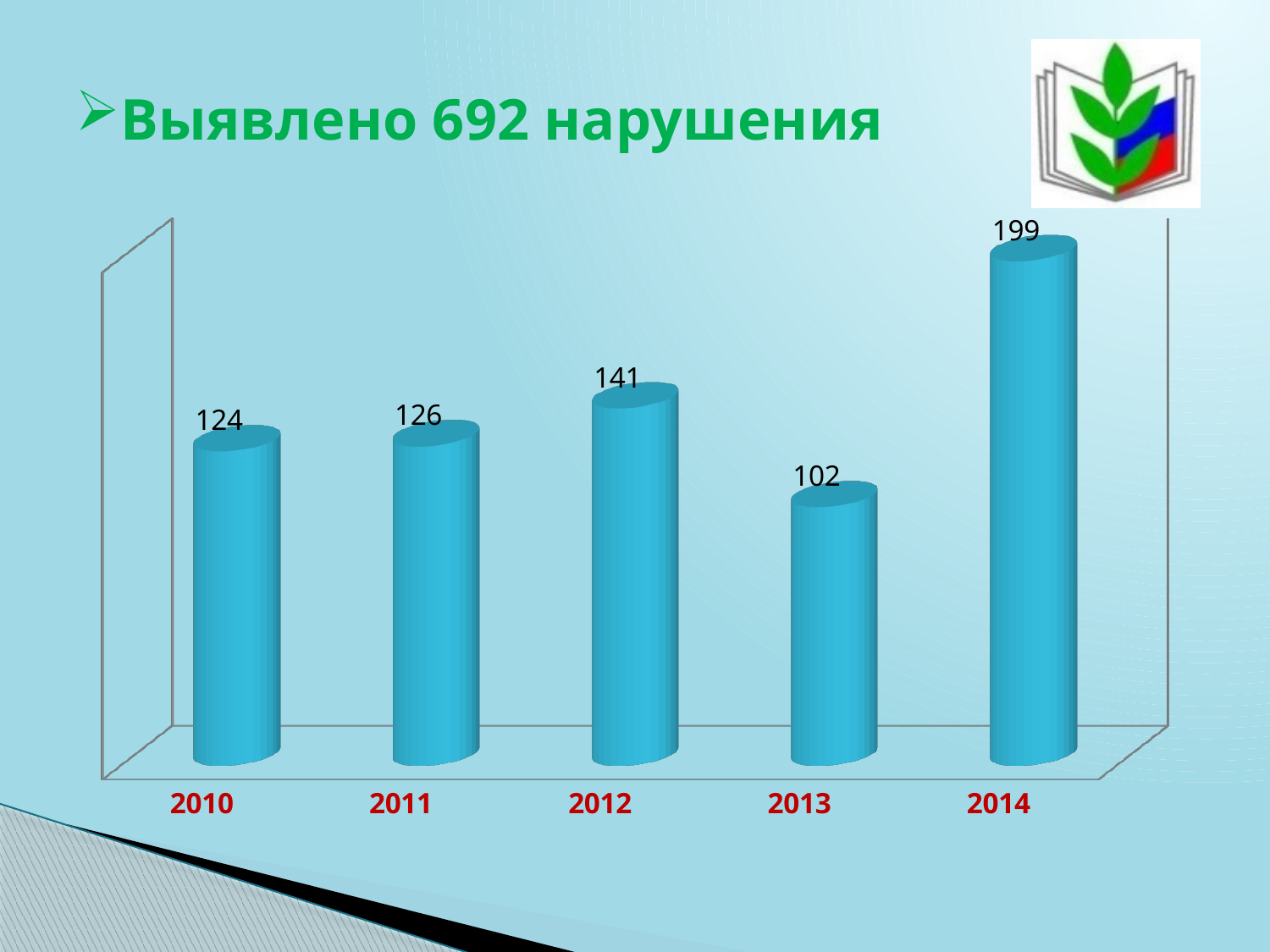
What is the difference between the values for 2012 and 2011? 15 What is the value for 2014? 199 What is the value for 2010? 124 What kind of chart is shown on the slide? bar chart What is the total of all the values shown on the chart? 692 What is the difference between the values for 2014 and 2013? 97 Which year has the lowest value? 2013 Which is larger, the value for 2012 or the value for 2010? 2012 How many years are shown on the chart? 5 What is the value for 2012? 141 Which year has the highest value? 2014 What is the value for 2013? 102